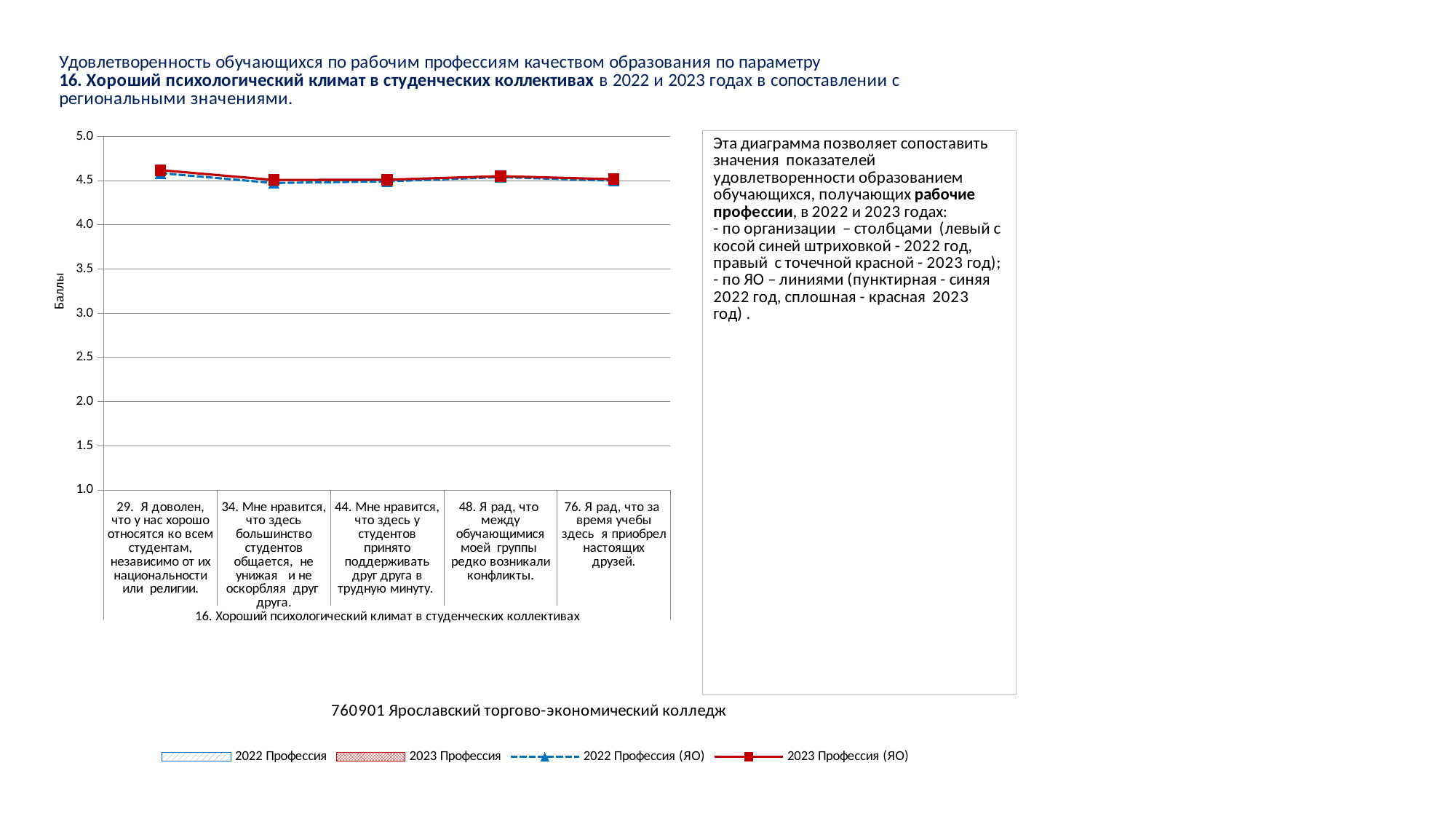
What is the lowest value shown on the y axis of the chart? 1.0 What is the label of the y axis of the chart? Баллы Is the value of the 2023 Профессия (ЯО) line for category 76 greater or less than 3.5? greater How many categories are shown along the x axis of the chart? 5 What kind of chart is shown on the slide? line chart What is the name of the last series listed in the chart legend? 2023 Профессия (ЯО) How many series does the chart legend list? 4 Is the value of the 2022 Профессия (ЯО) line for category 48 greater or less than 4.0? greater Is the value of the 2023 Профессия (ЯО) line for category 29 greater or less than 4.0? greater